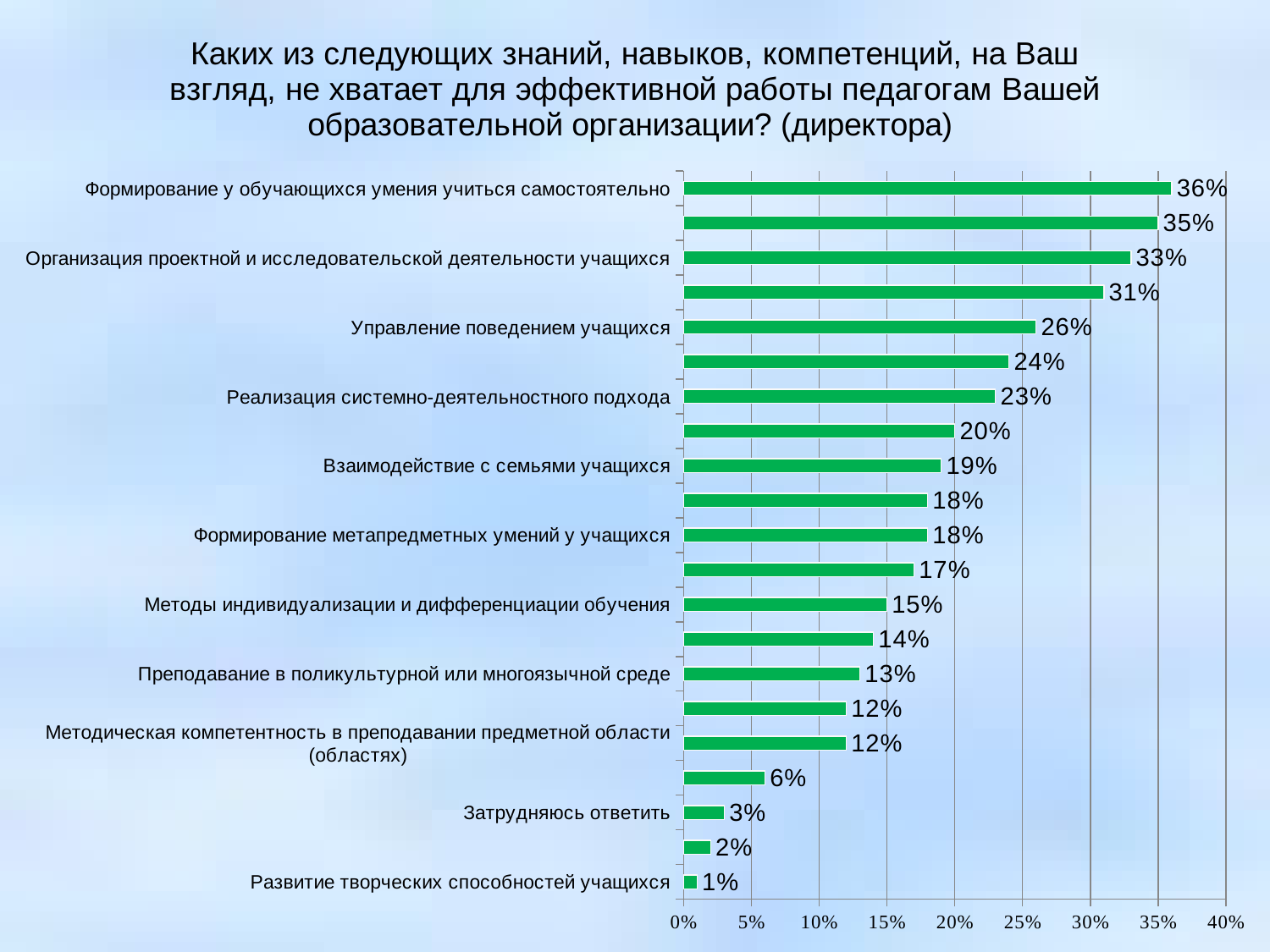
What value is shown for «Затрудняюсь ответить»? 3% Which category has the lowest value? Развитие творческих способностей учащихся What is the difference between the values for «Управление поведением учащихся» and «Реализация системно-деятельностного подхода»? 3% What kind of chart is shown on the slide? Bar chart Is the value for «Формирование метапредметных умений у учащихся» greater or less than 20%? less Which category has the highest value? Формирование у обучающихся умения учиться самостоятельно How many bars are plotted on the chart? 21 What value is shown for «Формирование у обучающихся умения учиться самостоятельно»? 36% What value is shown for «Организация проектной и исследовательской деятельности учащихся»? 33% What value is shown for «Взаимодействие с семьями учащихся»? 19% What value is shown for «Управление поведением учащихся»? 26% Which is larger: the value for «Методы индивидуализации и дифференциации обучения» or for «Преподавание в поликультурной или многоязычной среде»? Методы индивидуализации и дифференциации обучения